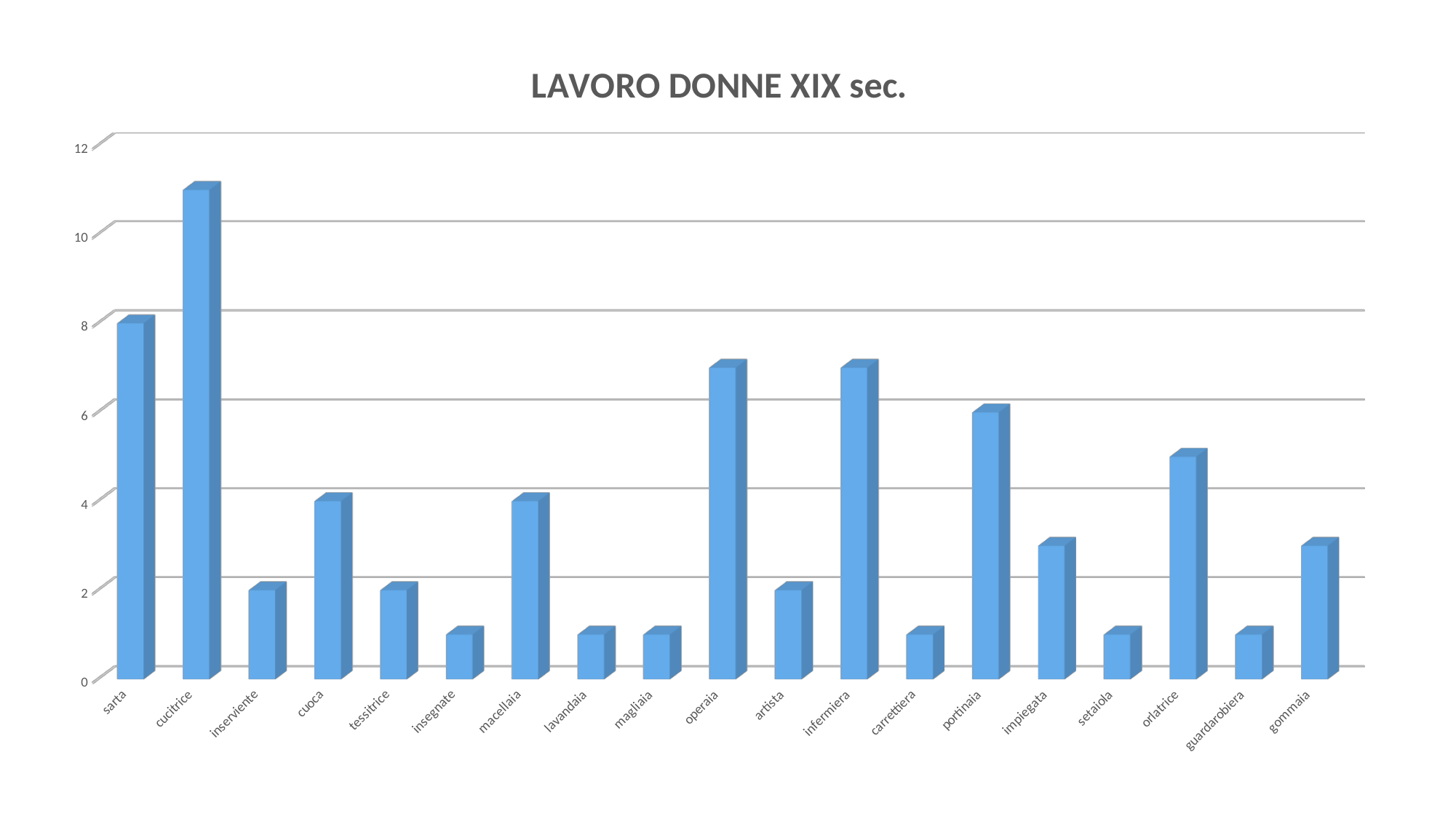
Which is larger, the value for insegnate or the value for macellaia? macellaia Is the value for cucitrice greater or less than 10? greater Which is larger, the value for sarta or the value for operaia? sarta What value does the bar for sarta reach on the y axis? 8 Which is larger, the value for portinaia or the value for cuoca? portinaia Is the value for orlatrice greater or less than 6? less What kind of chart is shown on the slide? bar chart What is the title of the chart? LAVORO DONNE XIX sec. How many categories are shown on the x axis? 19 Which category has the highest bar? cucitrice Is the value for operaia greater or less than 6? greater